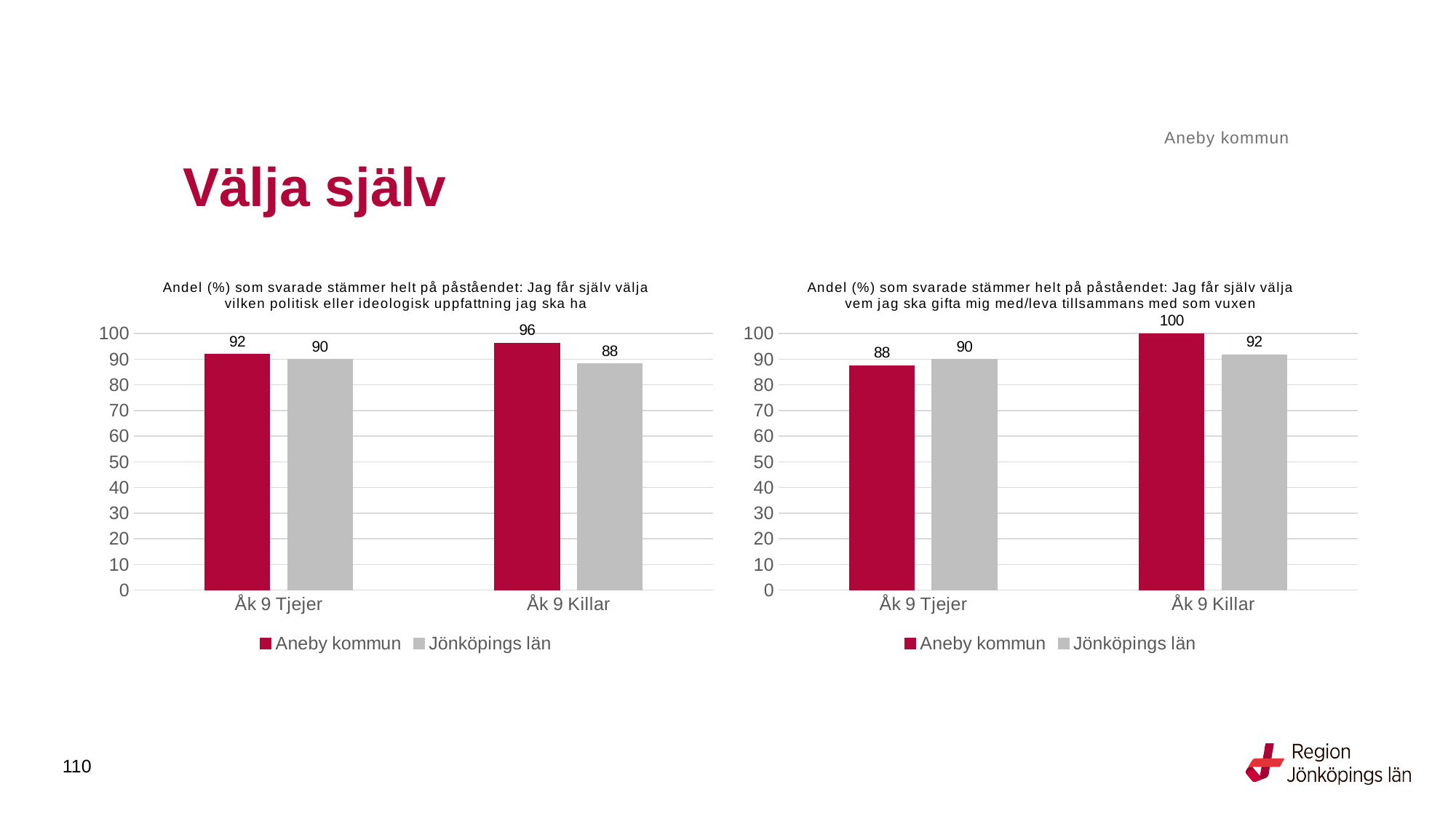
In the left chart (political or ideological opinion), which category has the highest Aneby kommun value? Åk 9 Killar In the left chart (political or ideological opinion), what is the value for Aneby kommun for Åk 9 Tjejer? 92 In the right chart (whom to marry/live with), what is the value for Aneby kommun for Åk 9 Killar? 100 In the right chart (whom to marry/live with), what is the value for Jönköpings län for Åk 9 Tjejer? 90 In the right chart (whom to marry/live with), which is larger for Åk 9 Tjejer: Aneby kommun or Jönköpings län? Jönköpings län In the left chart (political or ideological opinion), what is the value for Jönköpings län for Åk 9 Killar? 88 In the right chart (whom to marry/live with), which category has the lowest Aneby kommun value? Åk 9 Tjejer How many categories are shown on the x axis of the left chart? 2 What kind of chart is the right chart (whom to marry/live with)? Bar chart In the left chart (political or ideological opinion), what is the difference between the Aneby kommun and Jönköpings län values for Åk 9 Killar? 8 In the right chart (whom to marry/live with), what is the difference between the Aneby kommun and Jönköpings län values for Åk 9 Killar? 8 How many series does the legend of the left chart list? 2